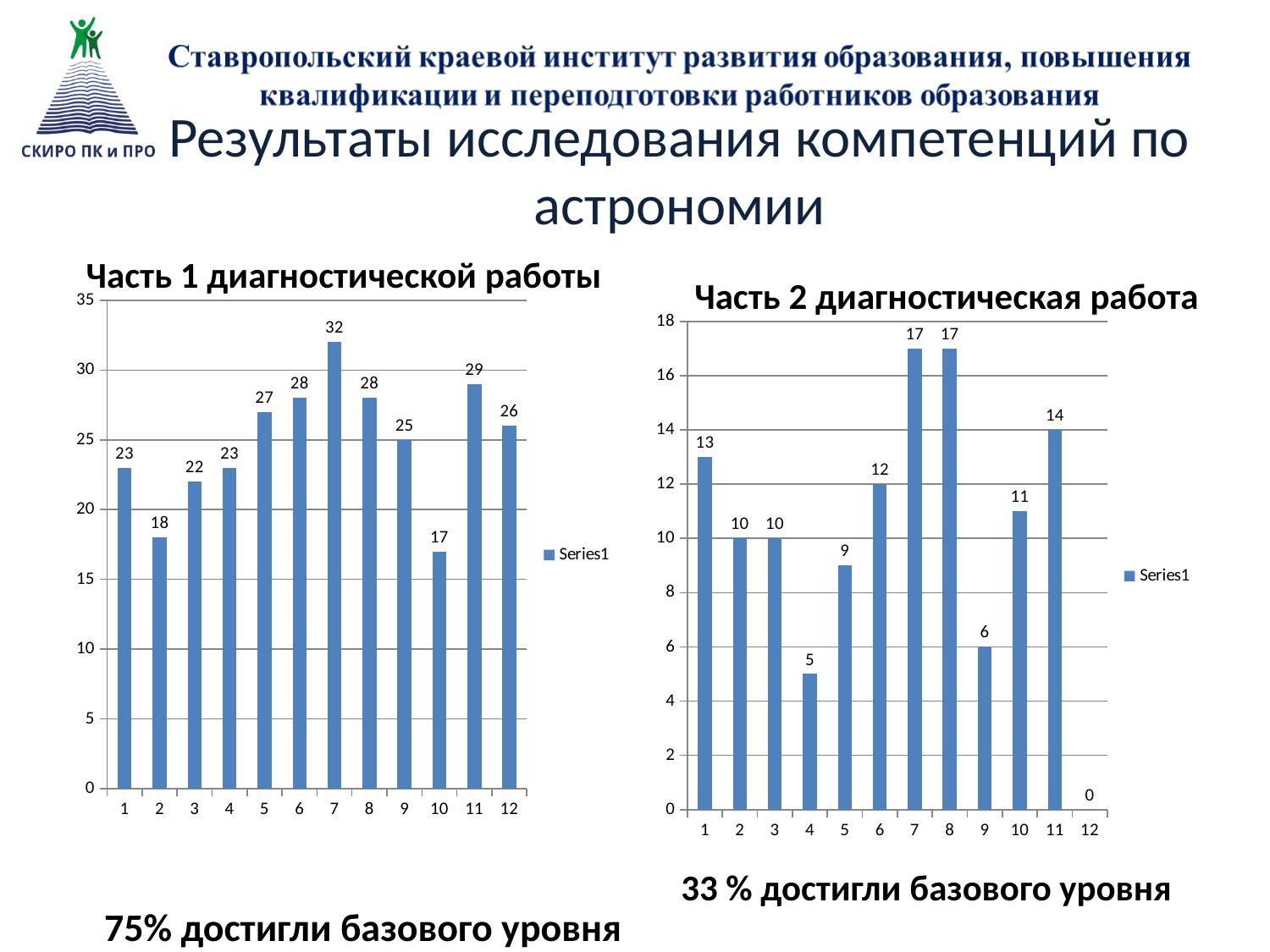
In the chart 'Часть 2 диагностическая работа', which is larger, the value for category 6 or the value for category 10? category 6 In the chart 'Часть 2 диагностическая работа', which category has the lowest value? 12 In the chart 'Часть 2 диагностическая работа', what is the difference between the values for category 7 and category 9? 11 In the chart 'Часть 1 диагностической работы', is the value for category 5 greater or less than 25? greater In the chart 'Часть 1 диагностической работы', what is the value for category 7? 32 In the chart 'Часть 1 диагностической работы', which category has the lowest value? 10 In the chart 'Часть 1 диагностической работы', how many categories are shown on the x axis? 12 In the chart 'Часть 1 диагностической работы', what is the difference between the values for category 11 and category 2? 11 In the chart 'Часть 2 диагностическая работа', what is the value for category 4? 5 In the chart 'Часть 1 диагностической работы', what is the name of the series shown in the legend? Series1 In the chart 'Часть 2 диагностическая работа', how many series does the legend list? 1 What kind of chart is 'Часть 2 диагностическая работа'? bar chart